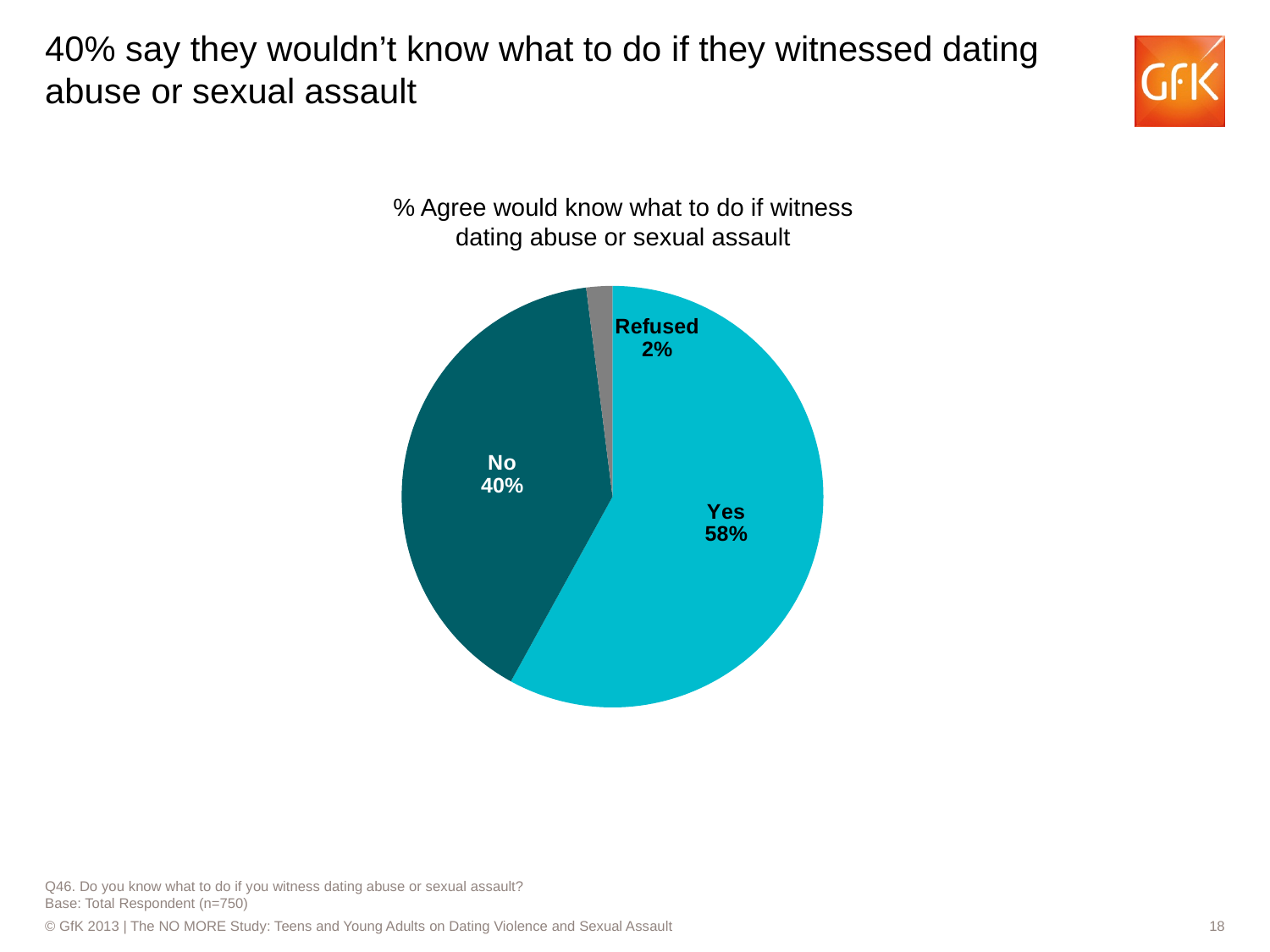
What percentage of respondents Refused? 2% What is the title of the pie chart? % Agree would know what to do if witness dating abuse or sexual assault What percentage of respondents answered Yes? 58% What is the combined percentage of the Yes and No slices? 98% Which slice of the pie is the smallest? Refused What share of the pie does the No slice represent? 40% Which slice of the pie is the largest? Yes What kind of chart is shown on the slide? pie chart What percentage of respondents answered No? 40% How many slices does the pie chart have? 3 Which is larger, the No slice or the Refused slice? No What is the difference in percentage points between the Yes and No slices? 18